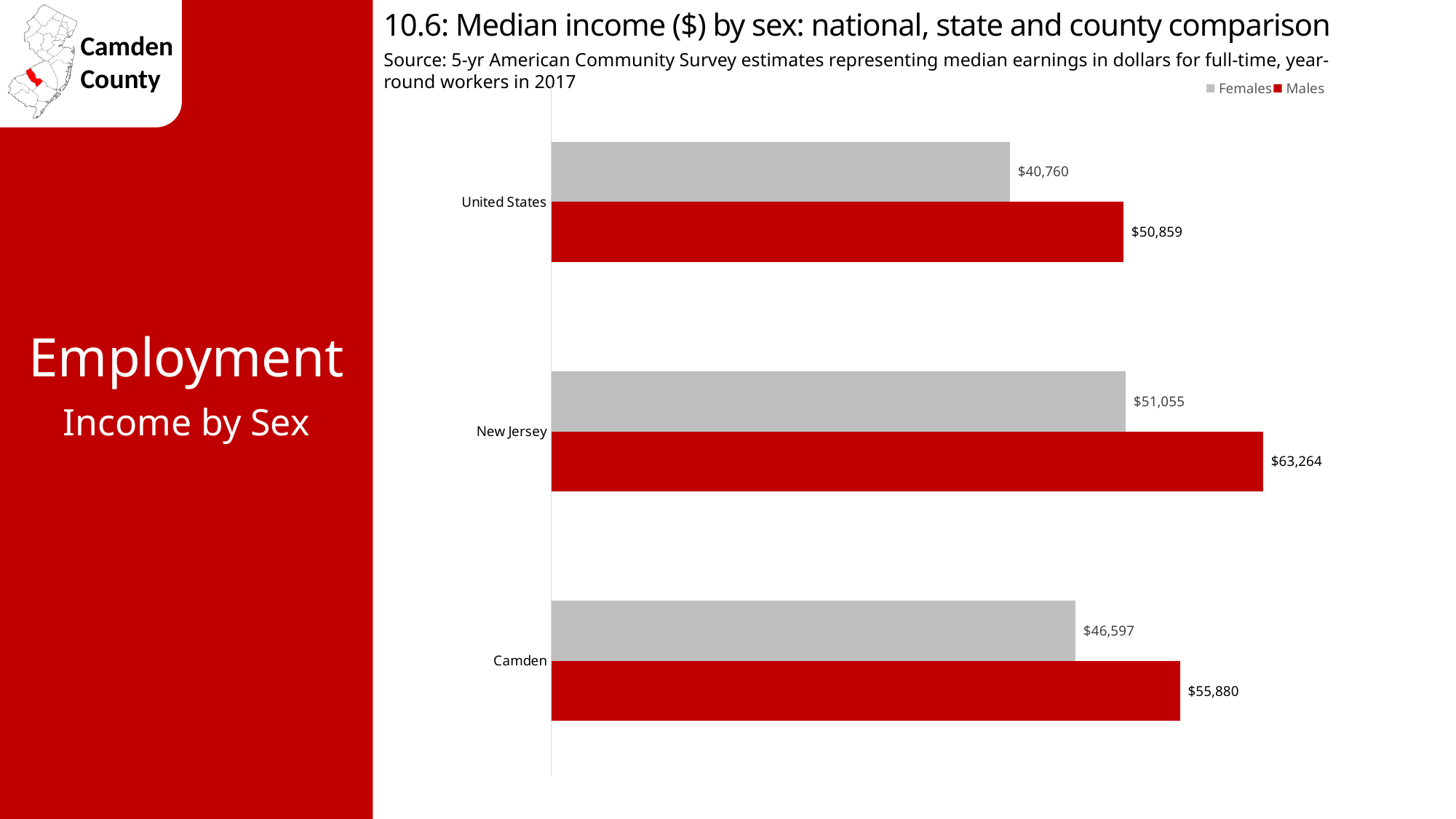
Which is larger: the female median income in New Jersey or the male median income in the United States? Female median income in New Jersey Which geography has the highest median income for males? New Jersey What is the difference between male and female median income in Camden? $9,283 What is the median income for females in Camden? $46,597 Which geography has the lowest median income for females? United States What kind of chart is shown on the slide? Bar chart How many series does the legend list? 2 How many geographies are shown on the chart? 3 What is the median income for males in New Jersey? $63,264 What is the median income for males in Camden? $55,880 What is the difference between male and female median income in New Jersey? $12,209 What is the median income for females in the United States? $40,760